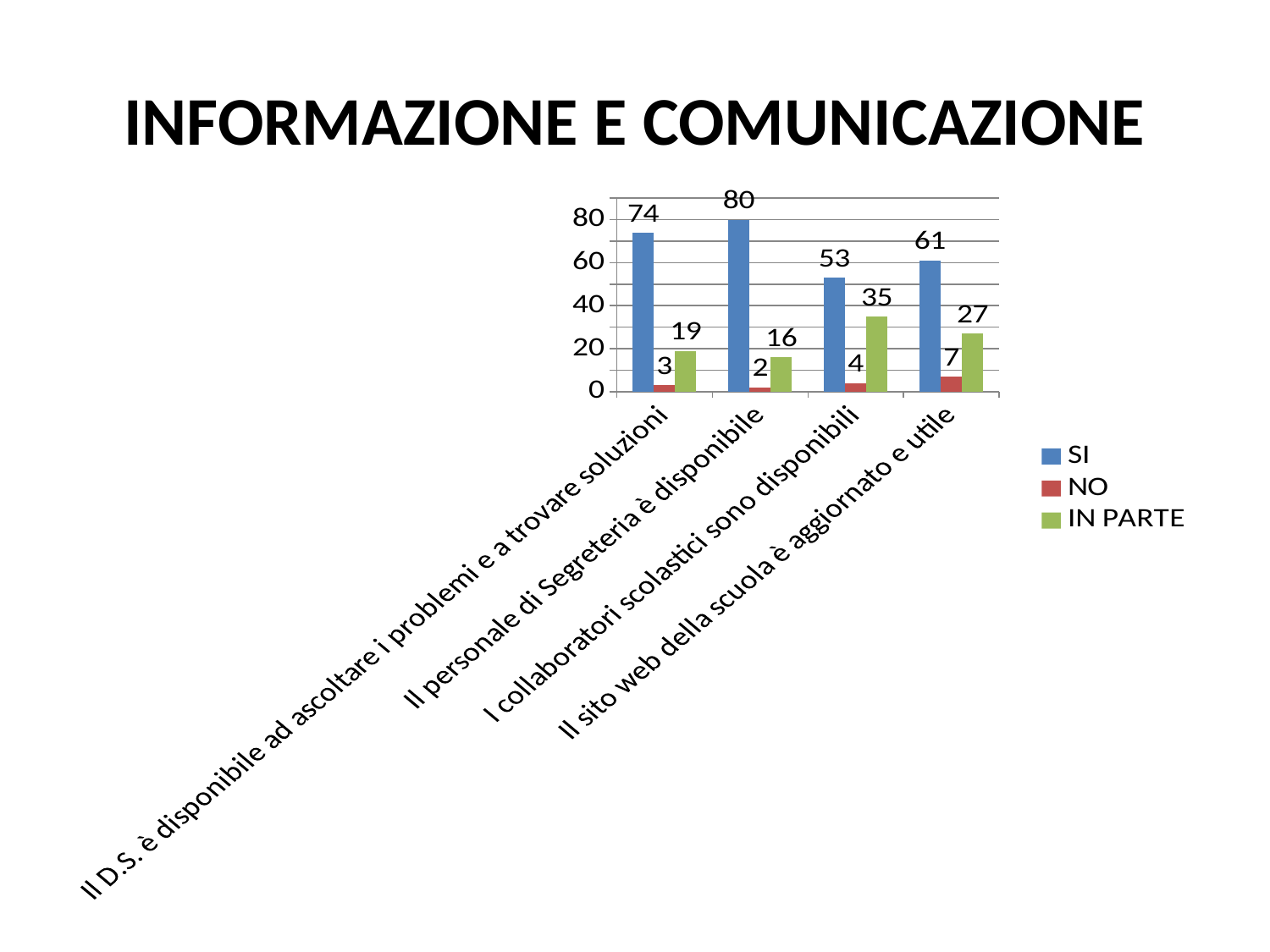
What is the title of the slide? INFORMAZIONE E COMUNICAZIONE Which category has the highest SI value? Il personale di Segreteria è disponibile Which category has the lowest NO value? Il personale di Segreteria è disponibile How many series does the legend list? 3 What is the difference between the SI values for "Il D.S. è disponibile ad ascoltare i problemi e a trovare soluzioni" and "Il sito web della scuola è aggiornato e utile"? 13 Which is larger: the IN PARTE value for "Il sito web della scuola è aggiornato e utile" or the IN PARTE value for "Il personale di Segreteria è disponibile"? Il sito web della scuola è aggiornato e utile What is the SI value for "Il personale di Segreteria è disponibile"? 80 What is the NO value for "Il sito web della scuola è aggiornato e utile"? 7 How many categories are shown on the x axis? 4 What kind of chart is shown on the slide? Bar chart Which colour represents the NO series? Red What is the IN PARTE value for "I collaboratori scolastici sono disponibili"? 35